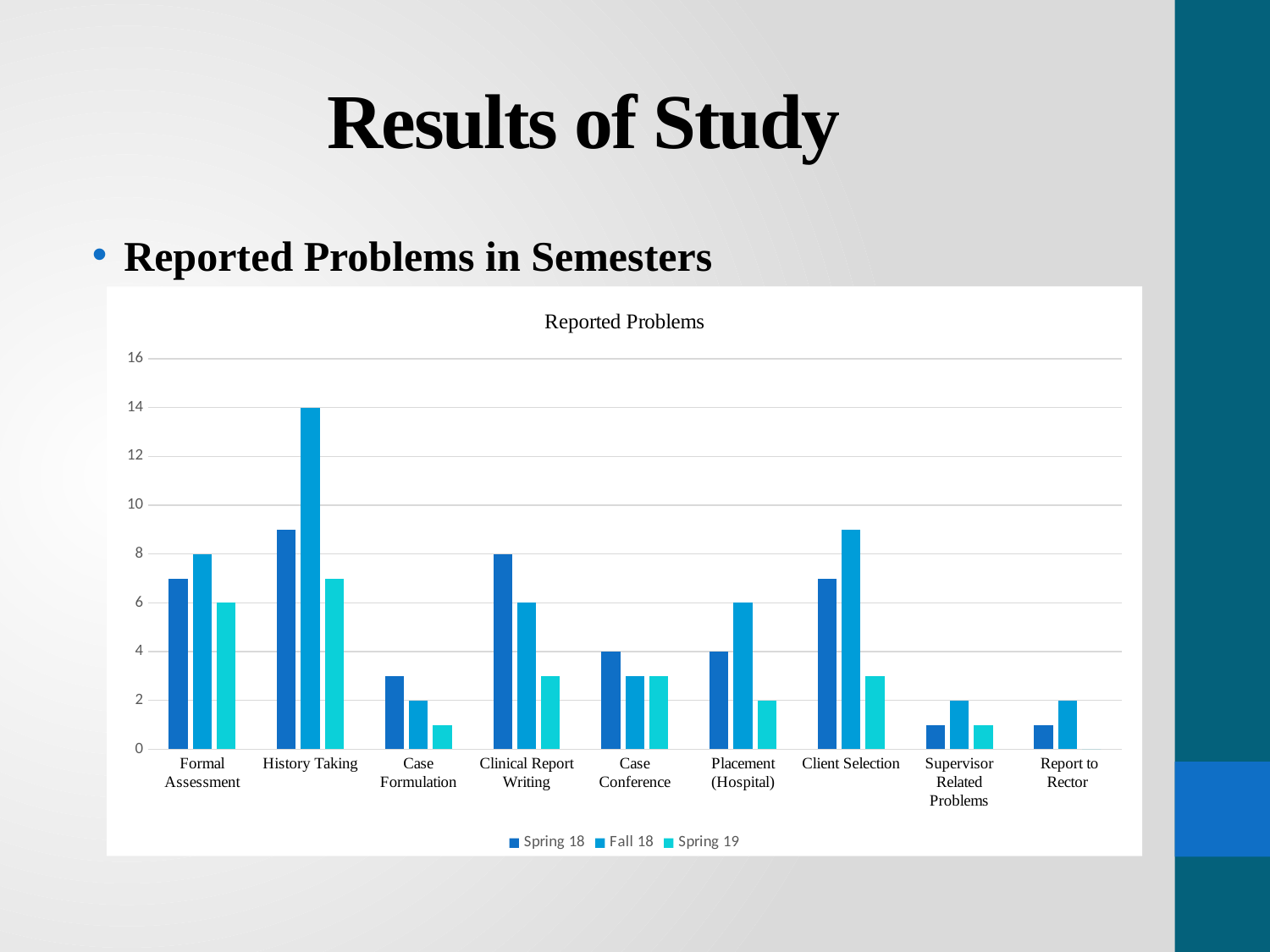
What is the value for Fall 18 in the Formal Assessment category? 8 Is the value for Spring 18 in the History Taking category greater or less than 6? greater What is the value for Fall 18 in the History Taking category? 14 Is the value for Fall 18 in the Client Selection category greater or less than 10? less How many categories are shown on the x axis? 9 Which category has the highest bar in the chart? History Taking What kind of chart is shown on the slide? bar chart What is the title of the chart? Reported Problems Which is larger for Client Selection, the Spring 18 value or the Fall 18 value? Fall 18 How many series does the legend list? 3 What is the difference between the Fall 18 and Spring 19 values for Placement (Hospital)? 4 What is the value for Spring 18 in the Clinical Report Writing category? 8